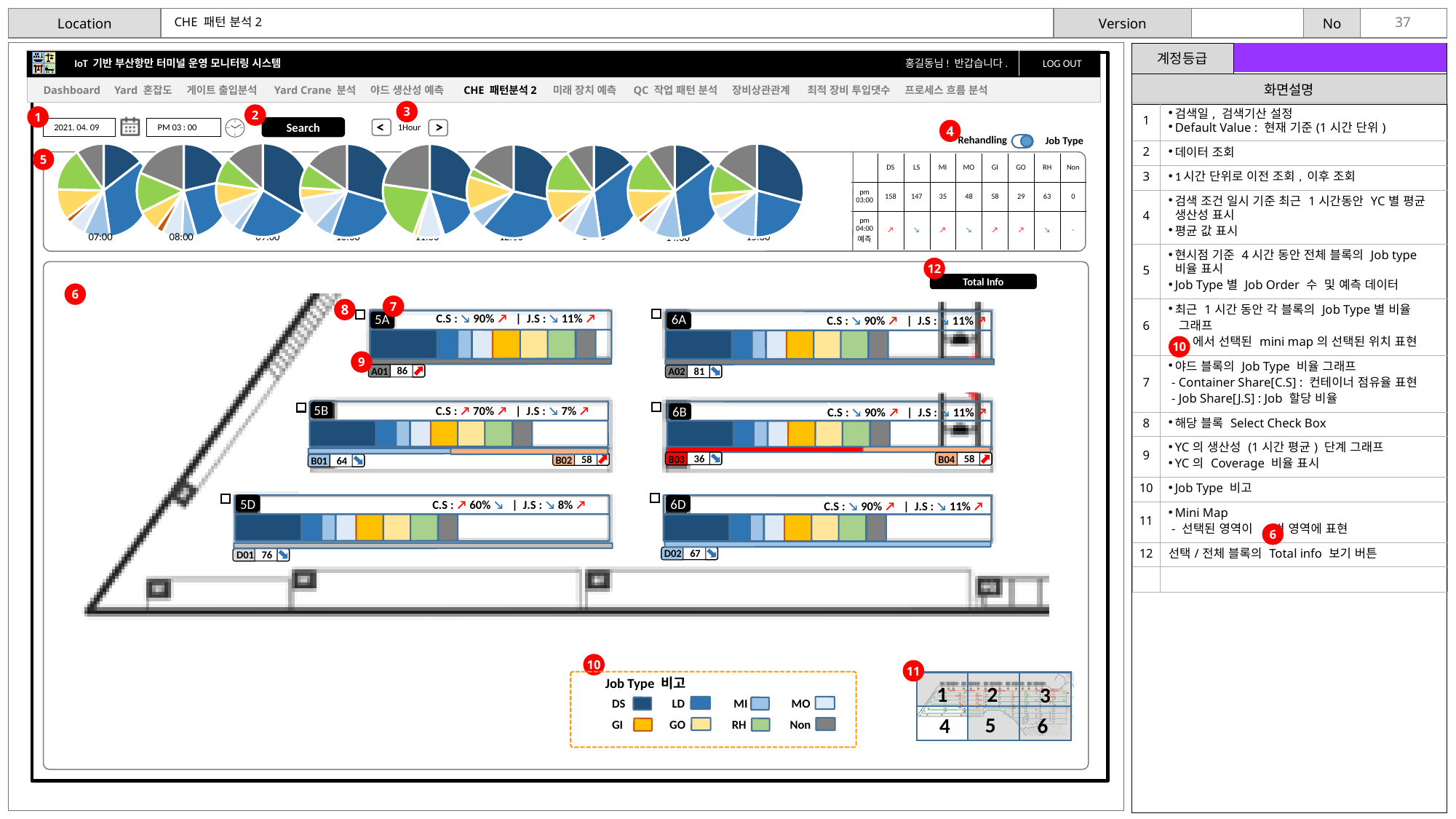
In the table to the right of the pie charts, what is the value for RH at pm 03:00? 63 In the block bar charts, what is the C.S value shown for block 5B? 70% In the table to the right of the pie charts, which job type has the highest value at pm 03:00? DS In the block bar charts, which block has the larger C.S value, 5A or 5D? 5A In the table to the right of the pie charts, which job type has the lowest value at pm 03:00? Non How many job types does the 'Job Type 비고' legend list? 8 In the table to the right of the pie charts, what is the difference between the DS and LS values at pm 03:00? 11 In the block bar charts, what is the J.S value shown for block 5D? 8% What kind of chart is used in the row at the top of the screen to show job type ratios per hour? pie chart In the table to the right of the pie charts, what is the value for DS at pm 03:00? 158 Among the YC productivity values shown under the block bars (A01, A02, B01, B02, B03, B04, D01, D02), which YC has the lowest value? B03 How many pie charts are shown in the row at the top of the screen? 9